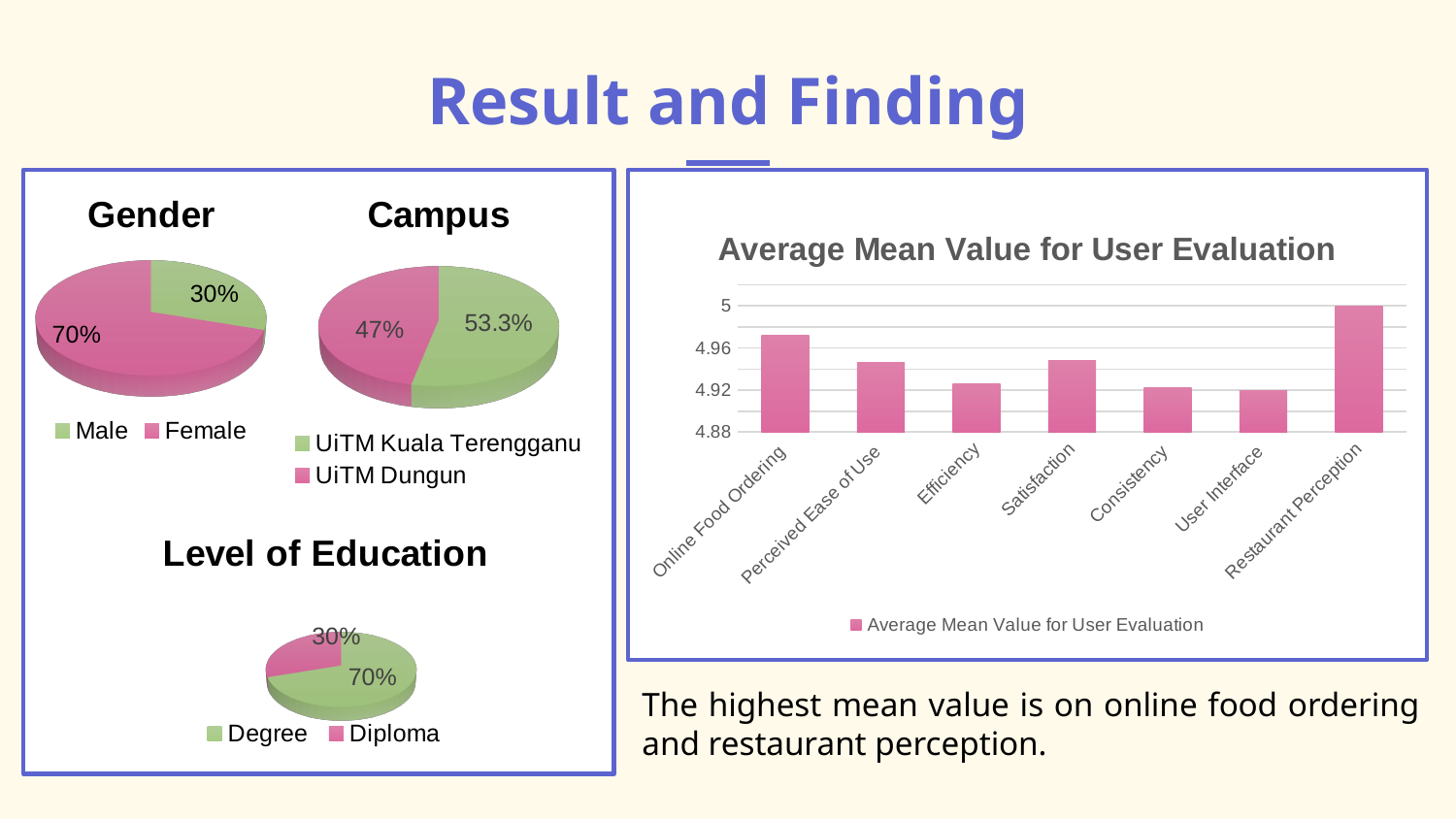
In the Level of Education pie chart, what is the difference between the Degree and Diploma shares? 40% In the Gender pie chart, what percentage is Female? 70% In the Campus pie chart, what percentage is UiTM Dungun? 47% In the Gender pie chart, which category is the smallest? Male In the Average Mean Value for User Evaluation chart, is the value for Online Food Ordering greater or less than 4.96? greater In the Average Mean Value for User Evaluation chart, is the value for Perceived Ease of Use greater or less than 4.96? less In the Level of Education pie chart, which category has the larger share, Degree or Diploma? Degree In the Average Mean Value for User Evaluation chart, which category has the highest value? Restaurant Perception In the Campus pie chart, what share is UiTM Kuala Terengganu? 53.3% How many categories are shown in the Average Mean Value for User Evaluation chart? 7 In the Average Mean Value for User Evaluation chart, which is larger, Online Food Ordering or Satisfaction? Online Food Ordering What kind of chart is the Average Mean Value for User Evaluation chart? bar chart